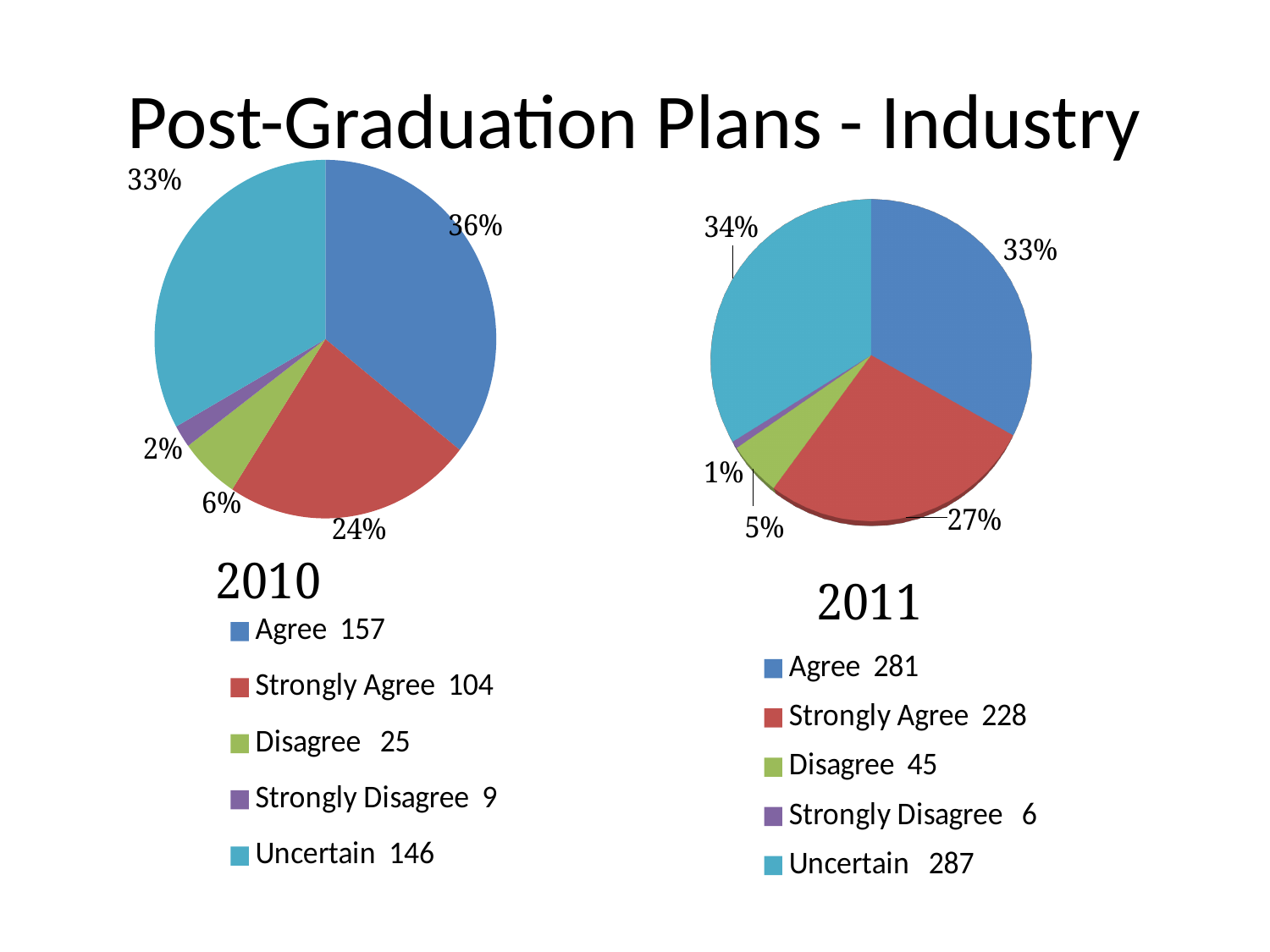
In the 2010 pie chart, what count is shown in the legend for Strongly Agree? 104 In the 2011 pie chart, what count is shown in the legend for Disagree? 45 In the 2011 pie chart, which category has the smallest slice? Strongly Disagree In the 2010 pie chart, what percentage share does the Strongly Disagree slice have? 2% In the 2011 pie chart, what percentage share does the Uncertain slice have? 34% What is the title of the slide containing the two pie charts? Post-Graduation Plans - Industry In the 2011 pie chart, what is the difference between the Agree count and the Strongly Agree count shown in the legend? 53 What kind of chart is used for the 2010 data? Pie chart In the 2010 pie chart, which category has the largest slice? Agree In the 2010 pie chart, what percentage share does the Agree slice have? 36% In the 2010 pie chart, which is larger, the Uncertain slice or the Strongly Agree slice? Uncertain How many categories does the 2011 pie chart's legend list? 5